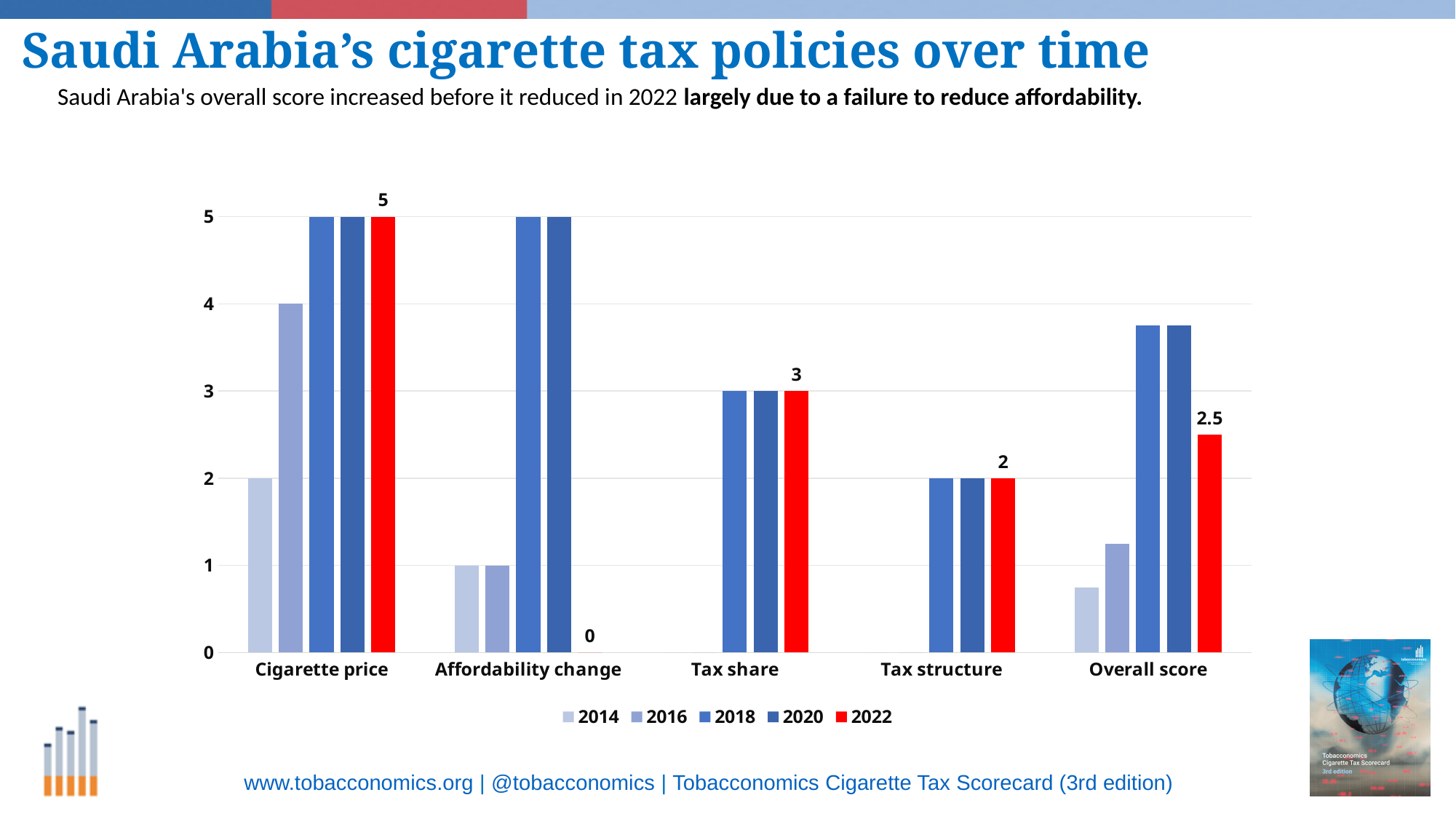
What is the 2022 value for Affordability change? 0 What is the 2016 value for Cigarette price? 4 Among the 2022 bars, which category has the lowest value? Affordability change What is the difference between the 2022 value for Cigarette price and the 2022 value for Overall score? 2.5 What is the 2022 value for Tax share? 3 What kind of chart is shown on the slide? Bar chart How many series does the legend list? 5 What is the 2022 value for Overall score? 2.5 How many categories are shown on the x axis? 5 Which is larger: the 2022 value for Tax share or the 2022 value for Tax structure? Tax share Among the 2022 bars, which category has the highest value? Cigarette price Is the 2018 value for Overall score greater or less than 3? greater